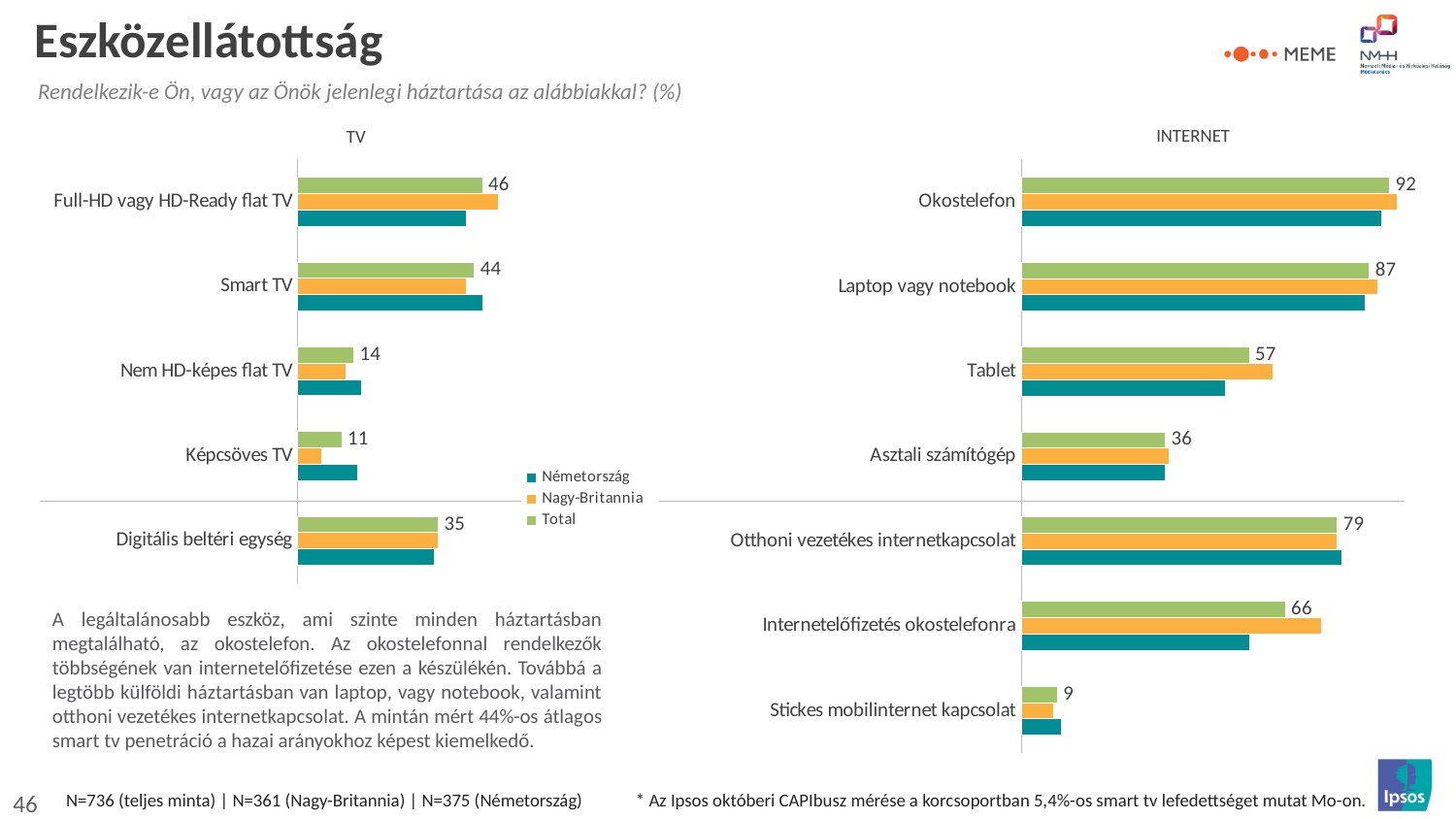
In the TV chart, what is the Total value for Smart TV? 44 What type of chart is the TV chart? Bar chart In the TV chart, which series is shown in orange? Nagy-Britannia In the TV chart, what is the Total value for Digitális beltéri egység? 35 How many series does the legend list for the TV chart? 3 How many categories are shown in the INTERNET chart? 7 In the TV chart, which has a larger Total value: Nem HD-képes flat TV or Digitális beltéri egység? Digitális beltéri egység In the INTERNET chart, what is the difference between the Total values for Okostelefon and Laptop vagy notebook? 5 In the INTERNET chart, what is the Total value for Tablet? 57 In the INTERNET chart, what is the Total value for Otthoni vezetékes internetkapcsolat? 79 In the INTERNET chart, which category has the highest Total value? Okostelefon In the TV chart, which category has the lowest Total value? Képcsöves TV